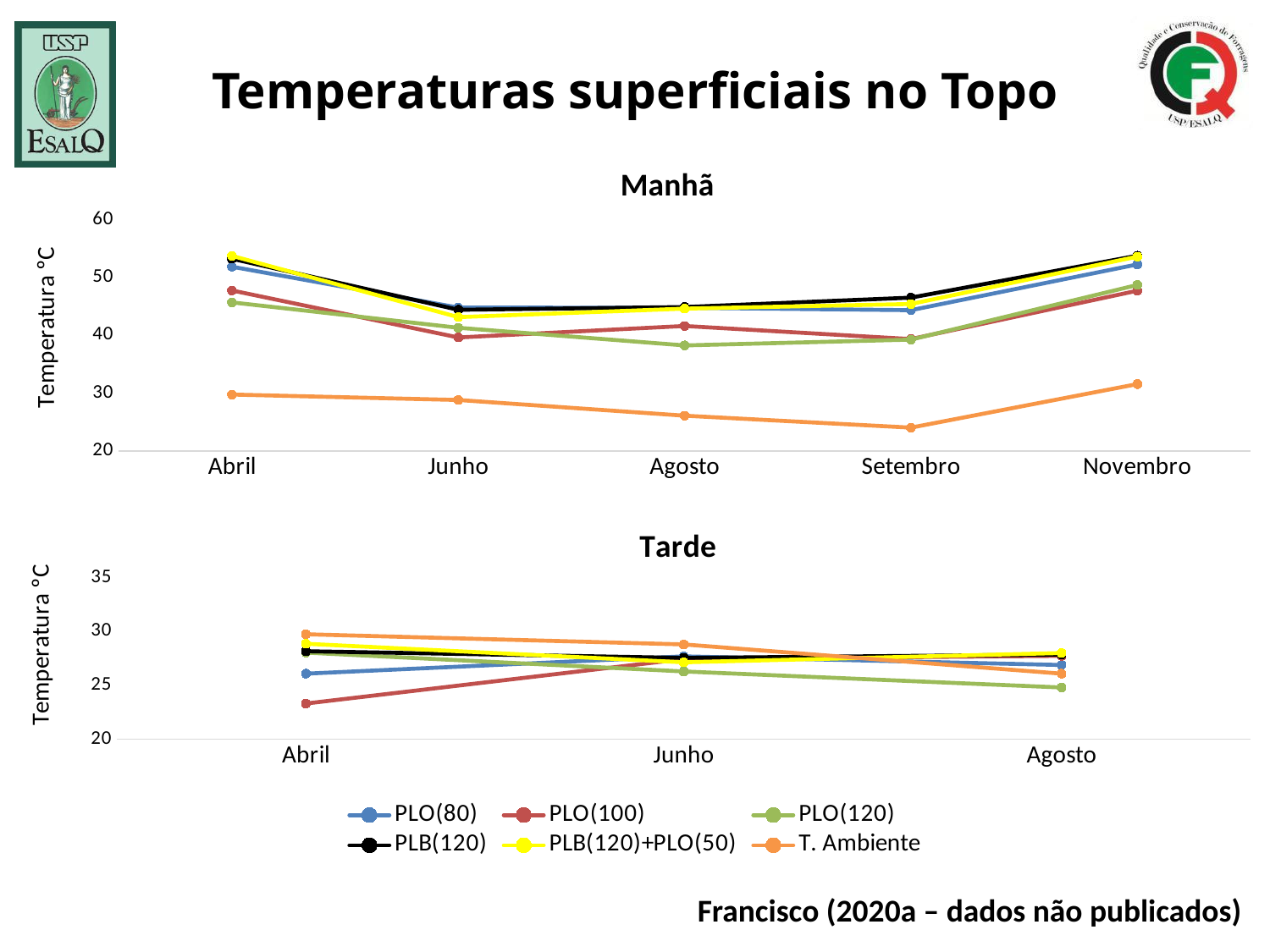
In the "Tarde" chart, how many months are shown on the x axis? 3 In the "Manhã" chart, which series has the lowest temperature in Setembro? T. Ambiente What kind of chart is the "Manhã" chart? line chart In the "Manhã" chart, is the value for PLB(120)+PLO(50) in Abril greater or less than 50? greater In the "Manhã" chart, how many months are shown on the x axis? 5 What is the y-axis label of the "Tarde" chart? Temperatura °C In the "Manhã" chart, is the value for T. Ambiente in Setembro greater or less than 30? less How many series does the legend list? 6 In the "Manhã" chart, is the value for PLO(120) in Agosto greater or less than 40? less In the "Manhã" chart, does the T. Ambiente series rise or fall from Abril to Setembro? fall In the "Tarde" chart, which series has the lowest temperature in Abril? PLO(100)